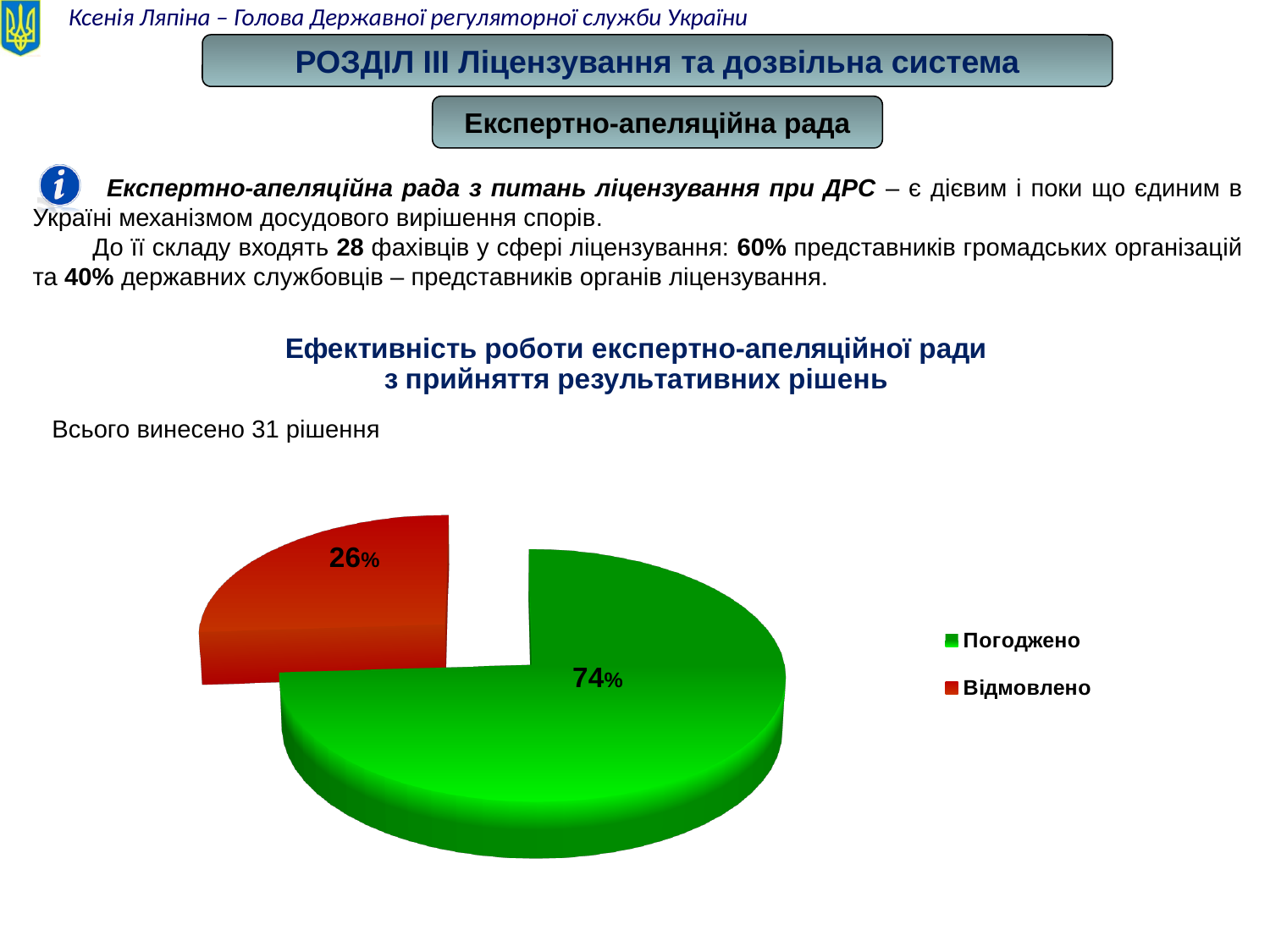
Is the share for Відмовлено greater or less than 50%? less How many entries does the legend list? 2 What colour is the Погоджено slice? green Which is larger, Погоджено or Відмовлено? Погоджено Which slice of the pie is the largest? Погоджено How many slices does the pie chart have? 2 What is the difference in percentage points between Погоджено and Відмовлено? 48 What colour is the Відмовлено slice? red What kind of chart is shown on the slide? pie chart What share of the pie does Погоджено represent? 74% Which slice of the pie is the smallest? Відмовлено What share of the pie does Відмовлено represent? 26%